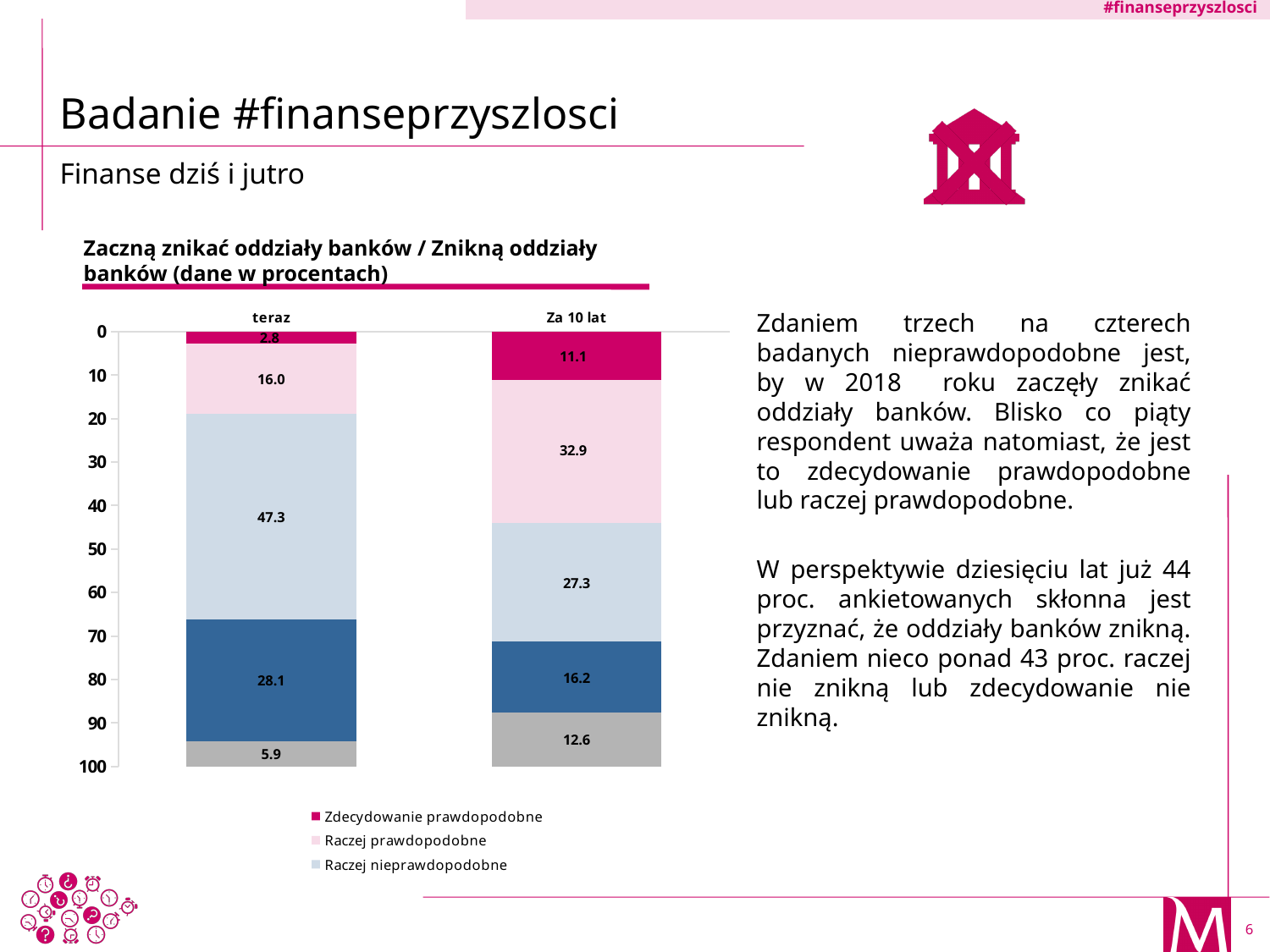
What is the value of the 'Raczej prawdopodobne' segment for 'Za 10 lat'? 32.9 What is the value of the 'Raczej nieprawdopodobne' segment for 'teraz'? 47.3 Which segment is the smallest in the 'teraz' bar? Zdecydowanie prawdopodobne What is the difference between the 'Raczej prawdopodobne' values for 'Za 10 lat' and 'teraz'? 16.9 How many series does the legend list? 3 What is the difference between the 'Zdecydowanie prawdopodobne' values for 'Za 10 lat' and 'teraz'? 8.3 What is the value of the 'Zdecydowanie prawdopodobne' segment for 'teraz'? 2.8 What is the value of the 'Zdecydowanie prawdopodobne' segment for 'Za 10 lat'? 11.1 How many categories (bars) are shown on the x axis? 2 Which category has the larger 'Raczej nieprawdopodobne' segment, 'teraz' or 'Za 10 lat'? teraz What type of chart is shown on the slide? Stacked bar chart Which segment is the largest in the 'teraz' bar? Raczej nieprawdopodobne